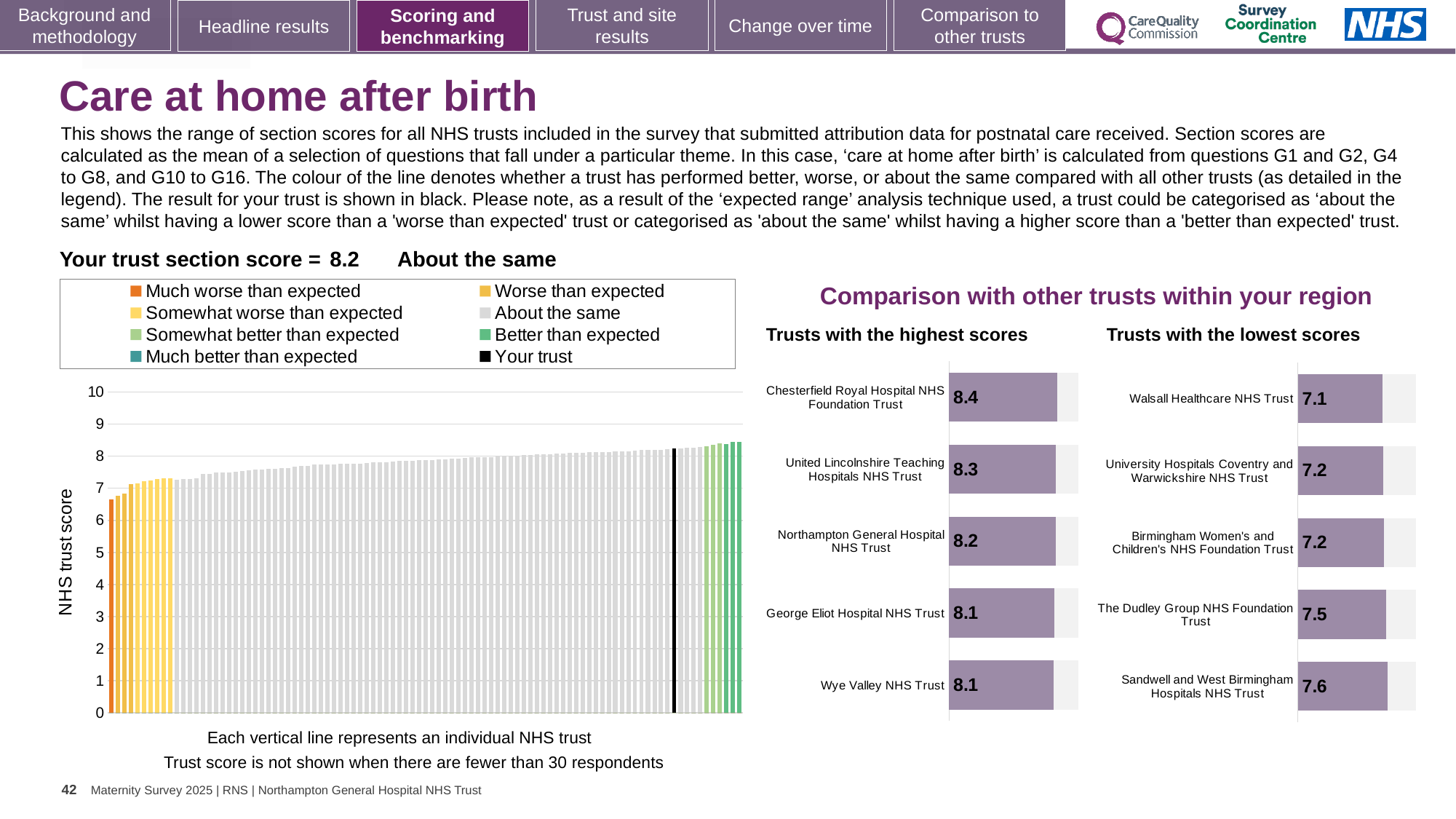
In the large 'NHS trust score' chart on the left, is the value of the leftmost bar greater or less than 7? less In the 'Trusts with the lowest scores' chart, what is the score for The Dudley Group NHS Foundation Trust? 7.5 How many trusts are shown in the 'Trusts with the lowest scores' chart? 5 In the 'Trusts with the highest scores' chart, what is the score for Chesterfield Royal Hospital NHS Foundation Trust? 8.4 In the 'Trusts with the highest scores' chart, which has the higher score: United Lincolnshire Teaching Hospitals NHS Trust or George Eliot Hospital NHS Trust? United Lincolnshire Teaching Hospitals NHS Trust In the large 'NHS trust score' chart on the left, do the bar values rise or fall from left to right? rise In the 'Trusts with the highest scores' chart, what is the score for Northampton General Hospital NHS Trust? 8.2 In the 'Trusts with the lowest scores' chart, which trust has the lowest score? Walsall Healthcare NHS Trust In the 'Trusts with the lowest scores' chart, which trust has the highest score? Sandwell and West Birmingham Hospitals NHS Trust How many entries does the legend of the large 'NHS trust score' chart list? 8 In the 'Trusts with the lowest scores' chart, what is the difference between the scores of Sandwell and West Birmingham Hospitals NHS Trust and Walsall Healthcare NHS Trust? 0.5 In the 'Trusts with the highest scores' chart, what is the difference between the scores of Chesterfield Royal Hospital NHS Foundation Trust and Wye Valley NHS Trust? 0.3